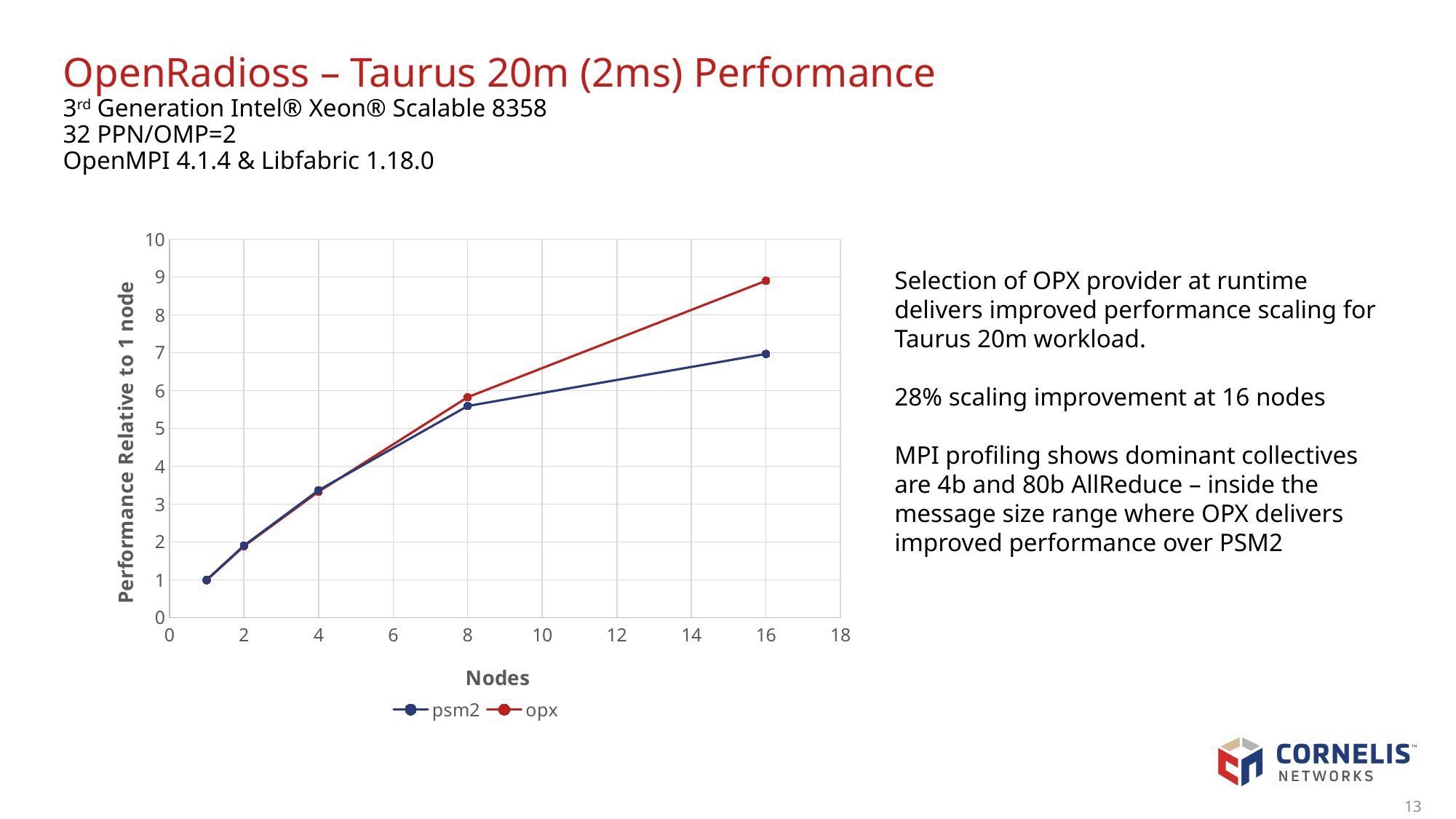
Is the value for opx at 8 nodes greater or less than 5? greater What is the label of the y axis? Performance Relative to 1 node What is the label of the x axis? Nodes How many data points are plotted for the opx series? 5 What kind of chart is shown on the slide? line chart Do the performance values rise or fall as the number of nodes increases? rise Which series reaches the highest performance value on the chart? opx How many series does the chart legend list? 2 Is the value for psm2 at 16 nodes greater or less than 6? greater Is the value for psm2 at 4 nodes greater or less than 3? greater At 16 nodes, which series has the higher performance value, psm2 or opx? opx